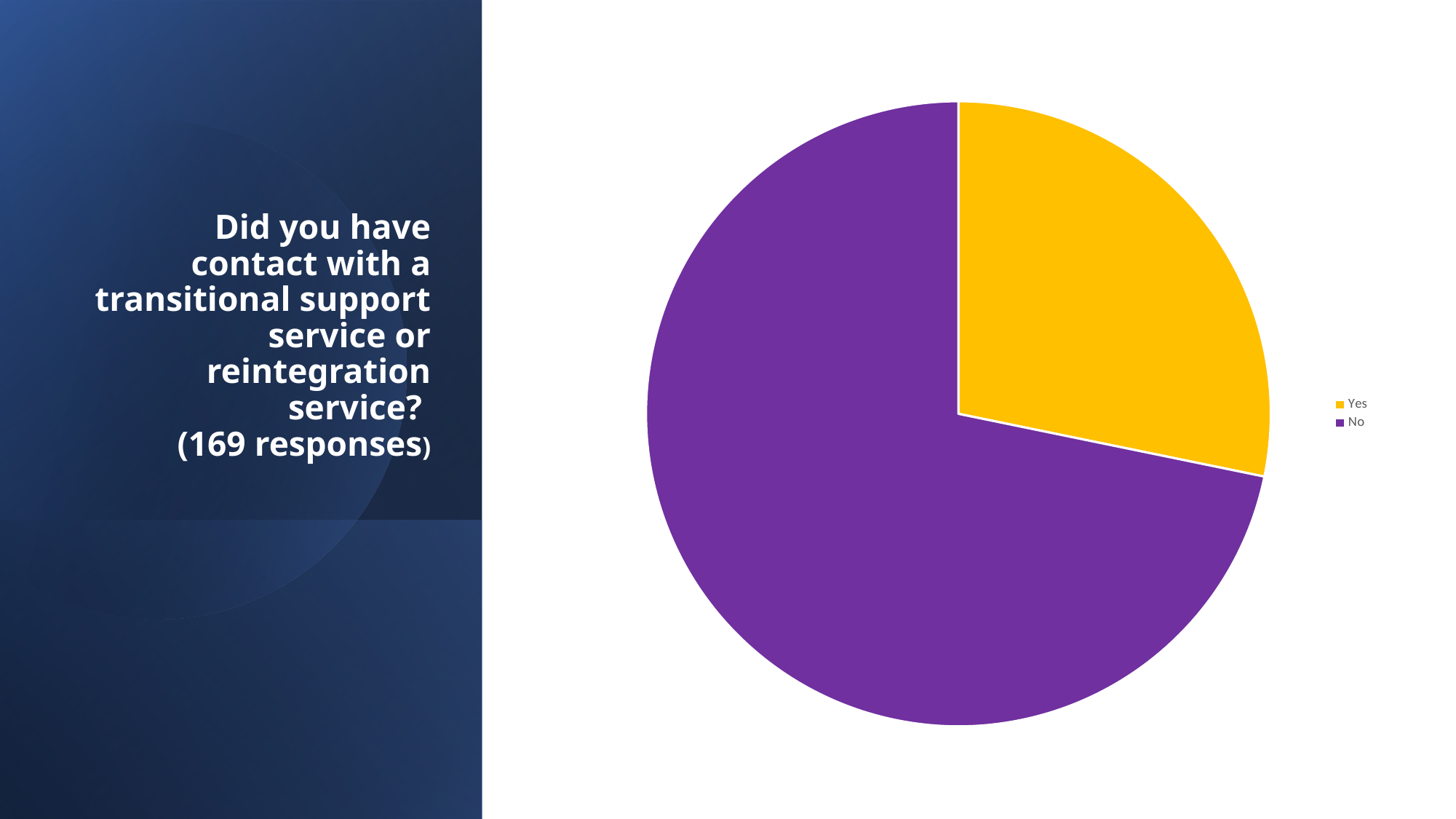
What colour is the Yes slice in the pie chart? Yellow Which category has the largest slice of the pie chart? No How many responses does the slide say the pie chart is based on? 169 Which slice is larger in the pie chart, Yes or No? No Does the Yes slice or the No slice take up more than half of the pie chart? No How many entries does the legend of the pie chart list? 2 How many slices does the pie chart have? 2 Which category has the smallest slice of the pie chart? Yes What kind of chart is shown on the slide? Pie chart What colour is the No slice in the pie chart? Purple